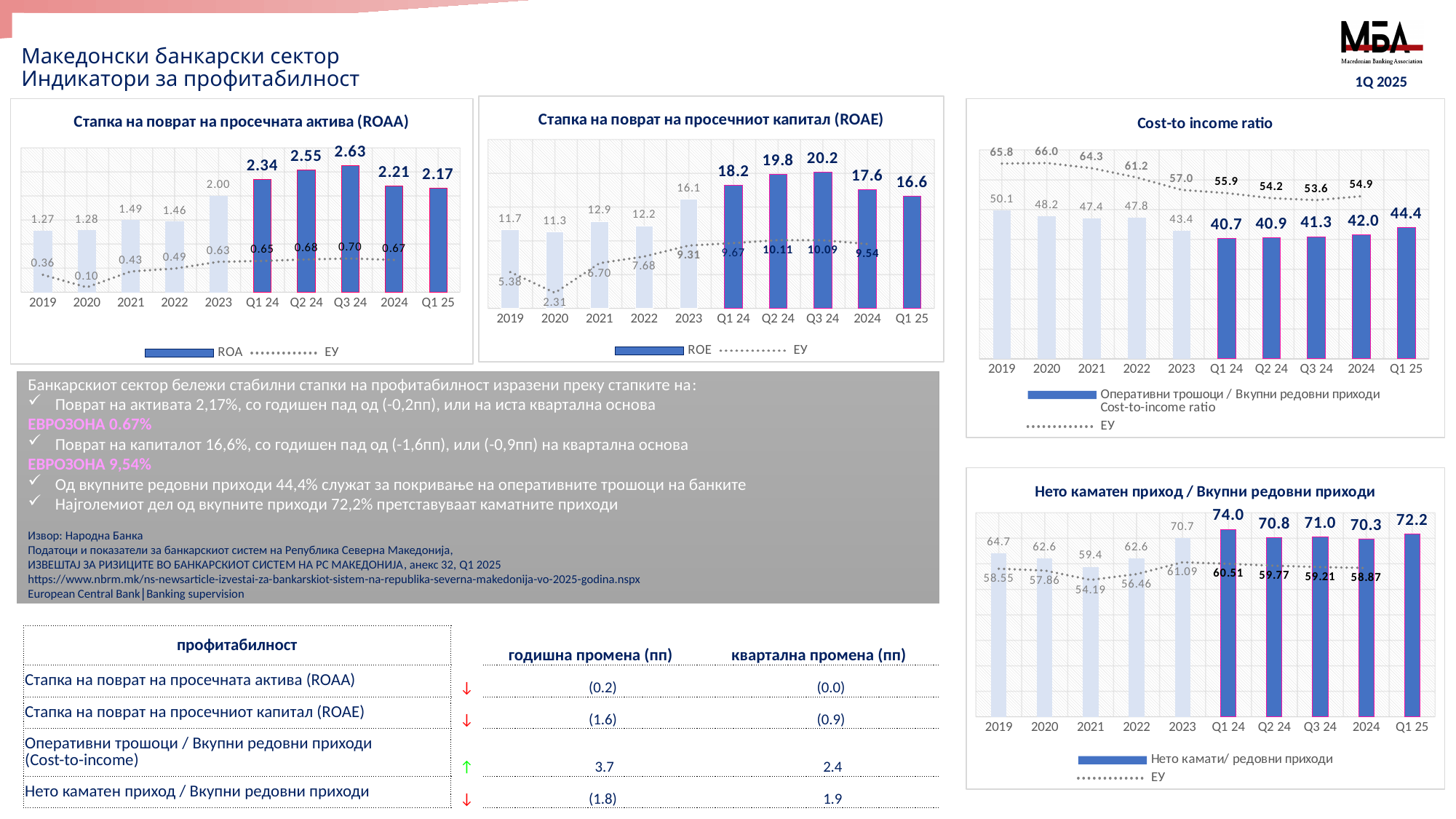
In the ROAE chart, which period has the lowest EU (ЕУ) value? 2020 In the Cost-to income ratio chart, what is the bar value for 2019? 50.1 In the ROAE chart, how many series does the legend list? 2 What type of chart is the Cost-to income ratio chart? Bar chart with a dotted line In the ROAA chart (Стапка на поврат на просечната актива), what is the ROA value for Q1 25? 2.17 In the ROAA chart, what is the EU (ЕУ) value for 2020? 0.10 In the ROAA chart, which period has the highest ROA bar? Q3 24 In the ROAE chart (Стапка на поврат на просечниот капитал), what is the difference between the ROE values for Q3 24 and Q1 25? 3.6 In the Нето каматен приход / Вкупни редовни приходи chart, what is the EU (ЕУ) value for 2021? 54.19 In the Нето каматен приход / Вкупни редовни приходи chart, what is the bar value for Q1 24? 74.0 In the Cost-to income ratio chart, how many periods are shown on the x axis? 10